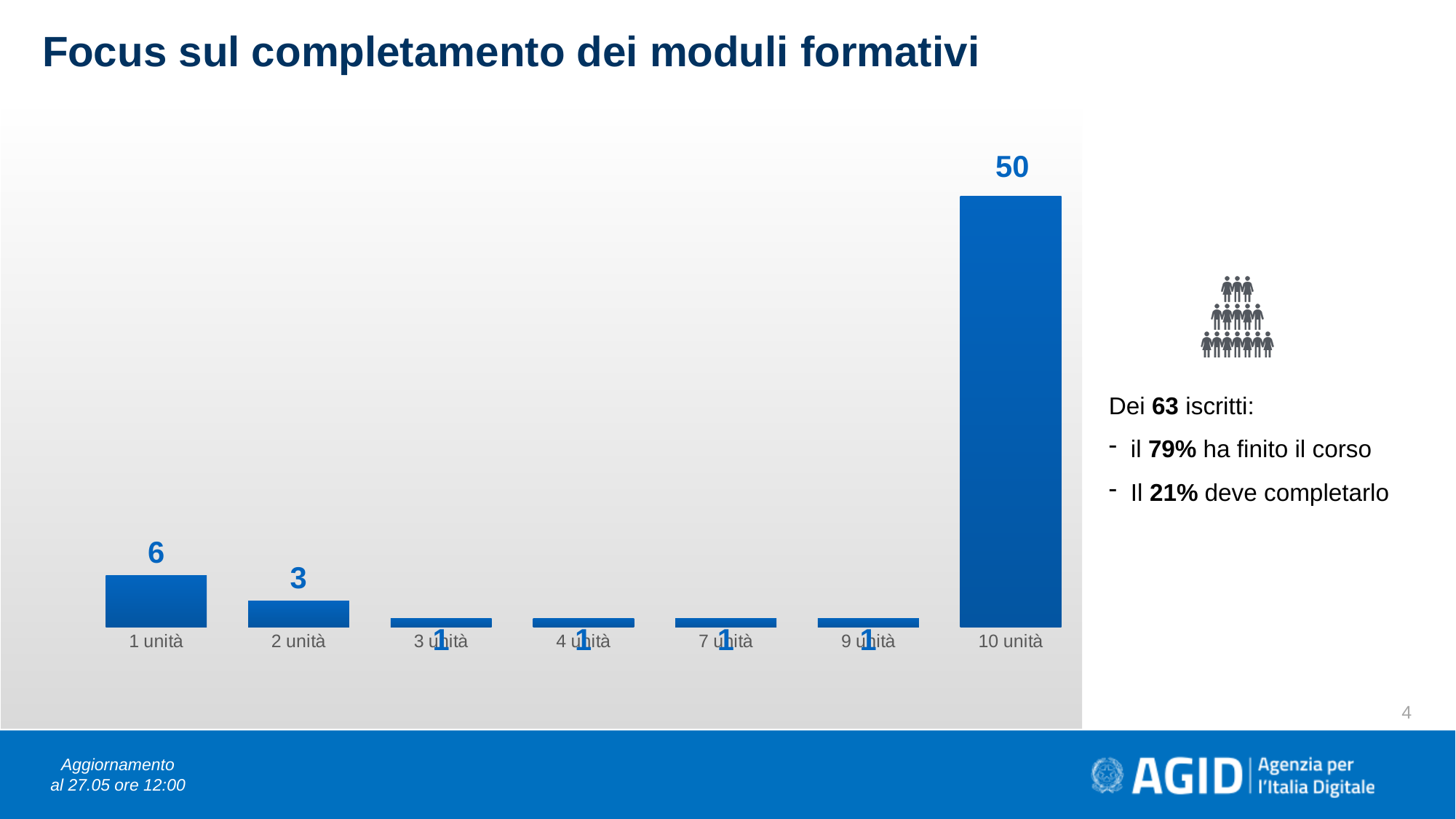
What is the difference between the values for 1 unità and 2 unità? 3 What is the value for 2 unità? 3 What is the value for 1 unità? 6 What is the value for 10 unità? 50 Which category has the highest value? 10 unità What is the title of the slide containing the chart? Focus sul completamento dei moduli formativi What is the difference between the values for 10 unità and 1 unità? 44 What is the value for 7 unità? 1 Which is larger, the value for 1 unità or the value for 2 unità? 1 unità What kind of chart is shown on the slide? bar chart How many categories have a value of 1? 4 How many categories are shown on the x axis? 7